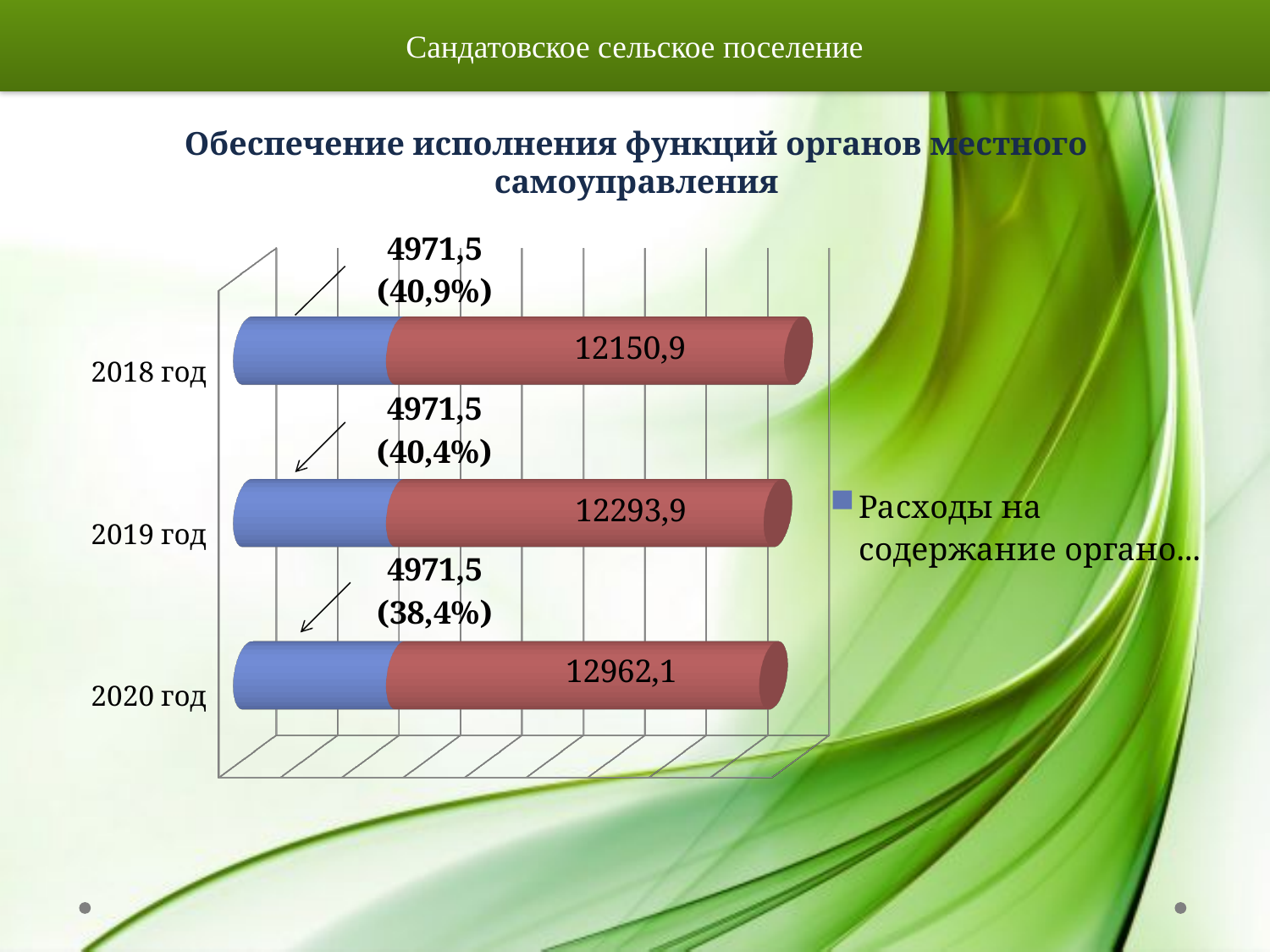
Which year has the highest value for the red segment? 2020 год What is the value of the red segment for 2020 год? 12962,1 What kind of chart is shown on the slide? Bar chart Which year has the lowest value for the red segment? 2018 год What is the value of the red segment for 2018 год? 12150,9 What is the value of the red segment for 2019 год? 12293,9 What percentage is shown in parentheses next to the blue segment for 2018 год? 40,9% What is the difference between the red segment values for 2020 год and 2018 год? 811,2 What percentage is shown in parentheses next to the blue segment for 2020 год? 38,4% What value is labelled on the blue segment for 2020 год? 4971,5 How many years (categories) are shown in the chart? 3 Which is larger, the red segment value for 2019 год or for 2020 год? 2020 год